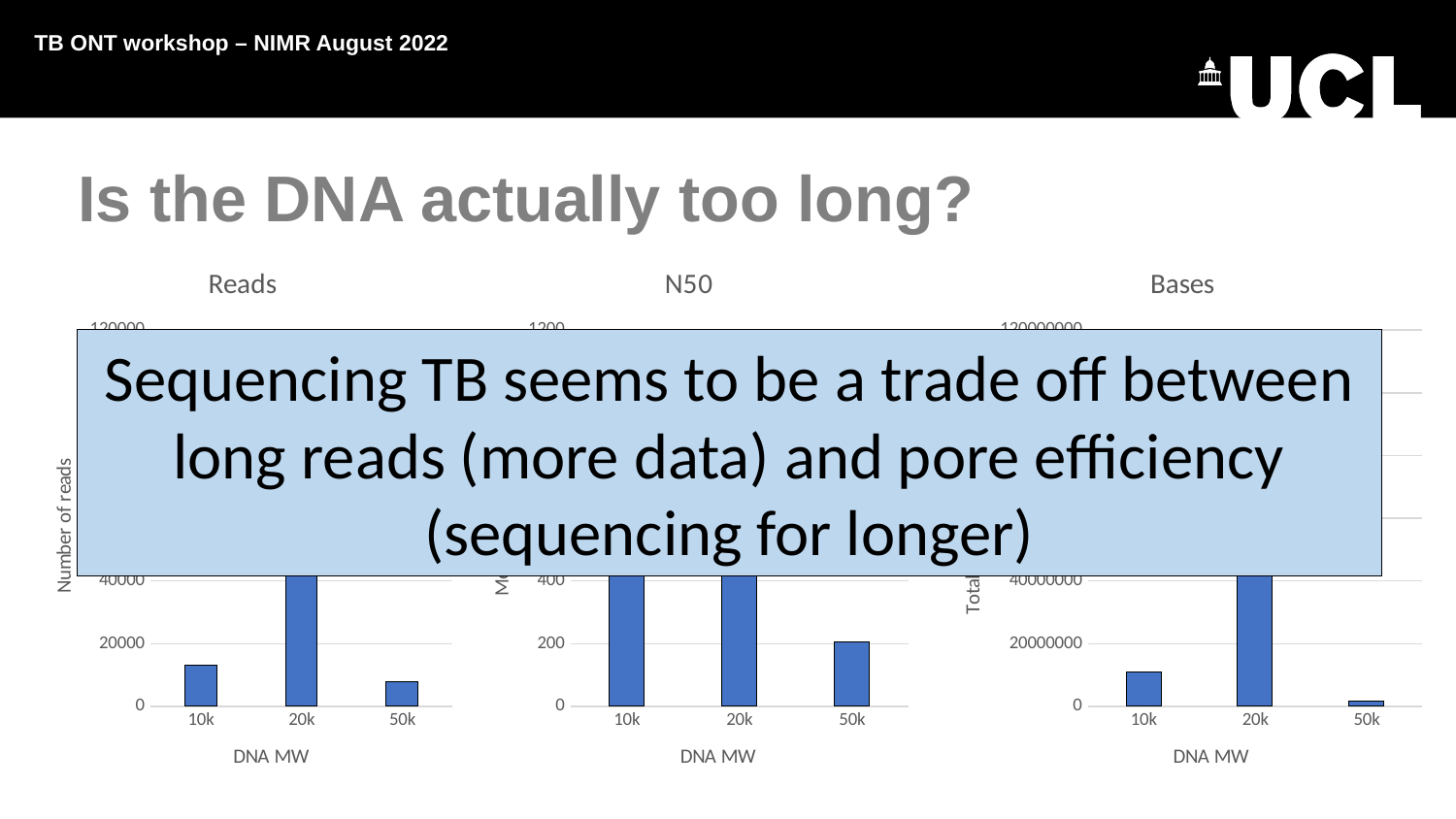
In the Reads chart, which is larger, the value for 10k or the value for 50k? 10k In the Reads chart, which DNA MW category has the lowest number of reads? 50k What is the x-axis title shared by the three charts? DNA MW In the Bases chart, which DNA MW category has the highest value? 20k In the Bases chart, is the value for 10k greater or less than 20000000? less In the N50 chart, is the value for 10k greater or less than 400? greater What type of chart is the Reads chart? bar chart How many categories are shown on the x axis of the N50 chart? 3 In the Reads chart, is the value for 10k greater or less than 20000? less In the Bases chart, which DNA MW category has the lowest value? 50k In the Reads chart, which DNA MW category has the highest number of reads? 20k